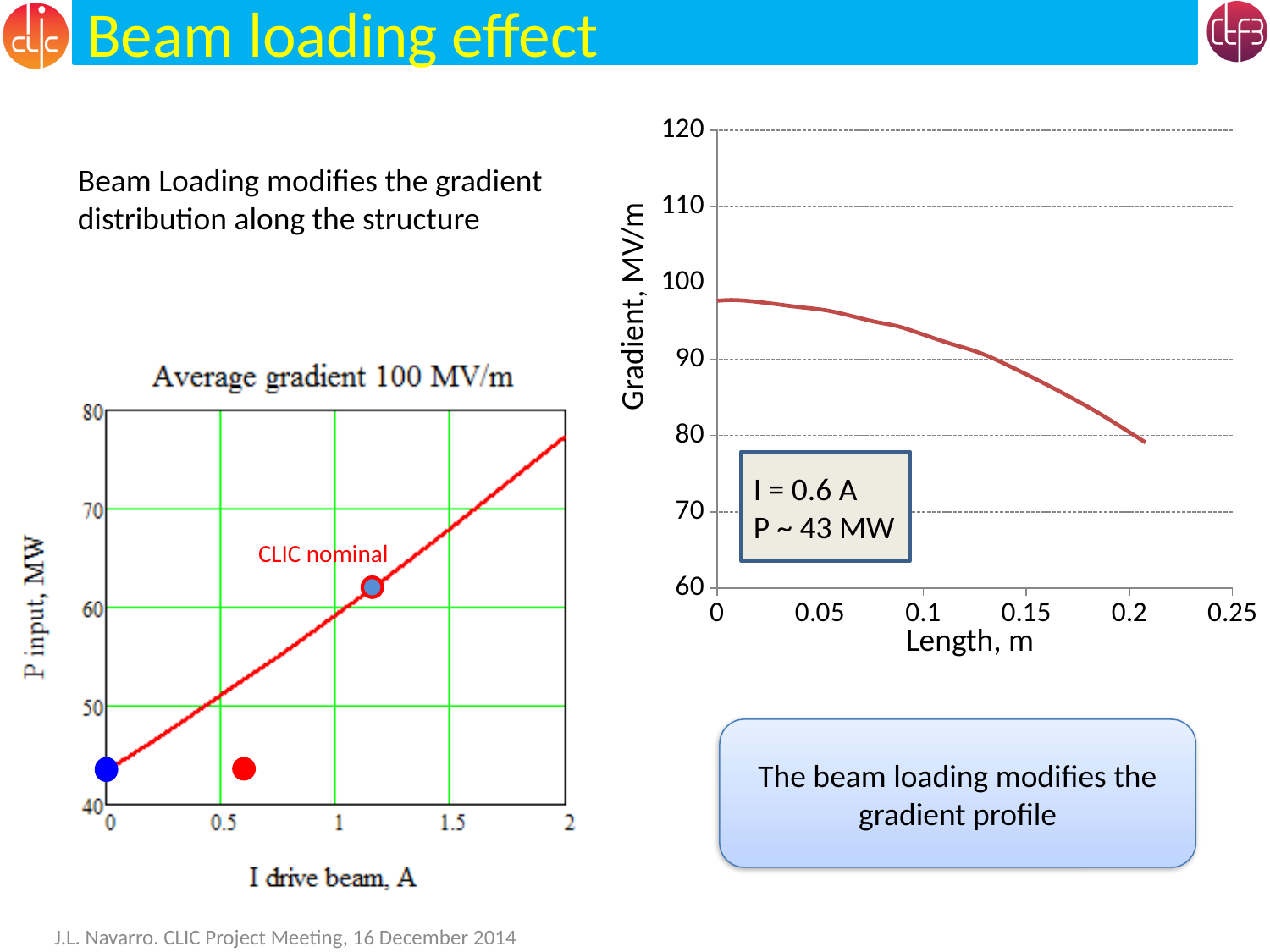
In the left-hand chart (Average gradient 100 MV/m), is the P input of the blue dot at I drive beam = 0 A greater or less than 50 MW? less In the right-hand chart (Gradient vs Length), does the gradient rise or fall as the length increases? fall What kind of chart is the right-hand chart of Gradient versus Length? line chart In the left-hand chart (Average gradient 100 MV/m), which has the larger P input: the CLIC nominal point or the red dot near 0.6 A? CLIC nominal In the right-hand chart (Gradient vs Length), what is the label of the y axis? Gradient, MV/m In the right-hand chart (Gradient vs Length), is the gradient at length 0 m greater or less than 90 MV/m? greater In the left-hand chart (Average gradient 100 MV/m), does P input rise or fall as I drive beam increases? rise In the left-hand chart (Average gradient 100 MV/m), is the P input on the red line at I drive beam = 2 A greater or less than 70 MW? greater What is the title of the left-hand chart of P input versus I drive beam? Average gradient 100 MV/m In the right-hand chart (Gradient vs Length), what drive beam current is stated in the annotation box? I = 0.6 A